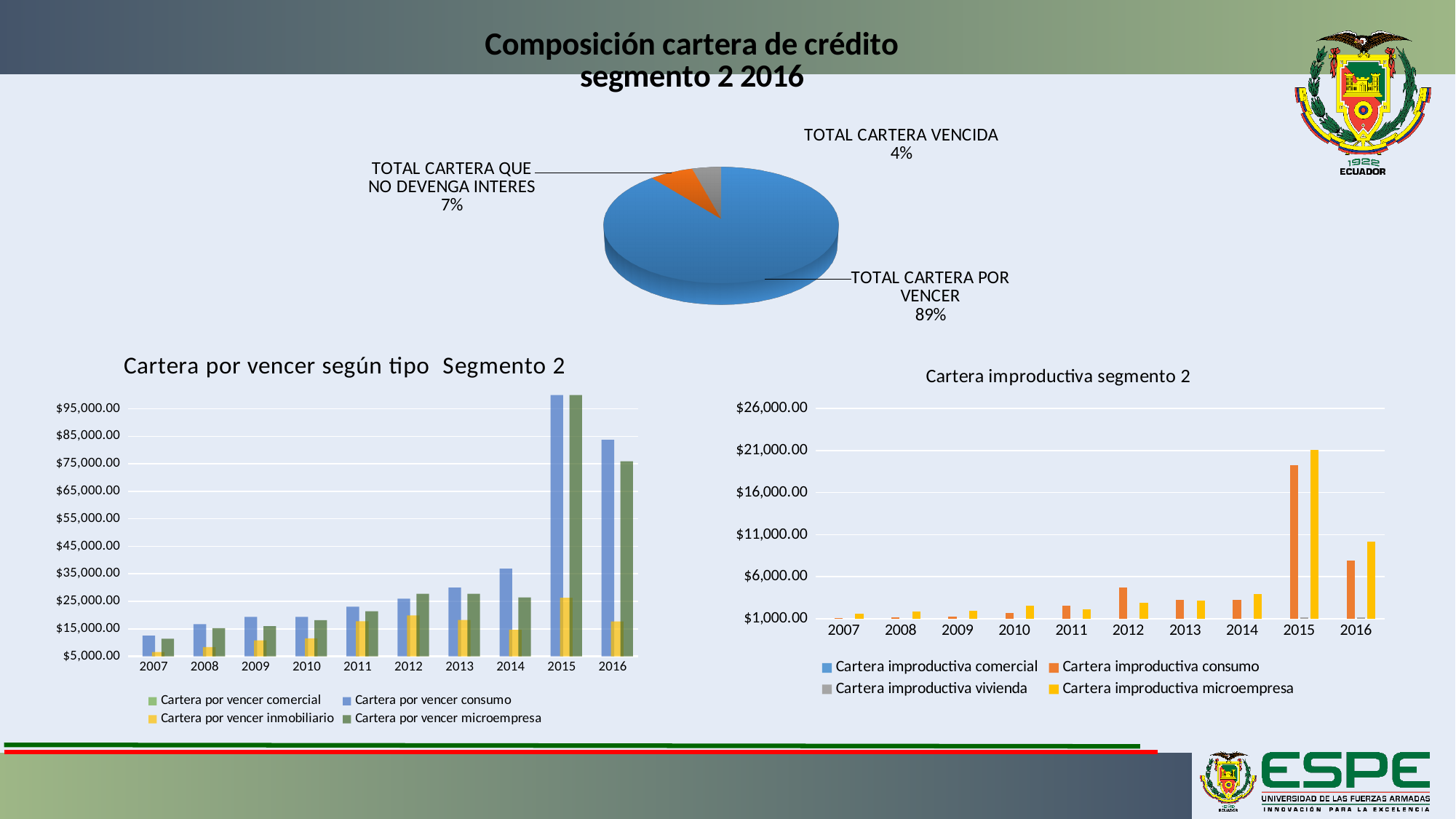
In the chart 'Cartera improductiva segmento 2', is the value for Cartera improductiva consumo in 2016 greater or less than $6,000.00? greater In the chart 'Cartera por vencer según tipo Segmento 2', how many series does the legend list? 4 In the chart 'Cartera por vencer según tipo Segmento 2', in which year is Cartera por vencer consumo highest? 2015 In the pie chart at the top of the slide, which slice is the smallest? TOTAL CARTERA VENCIDA In the chart 'Cartera por vencer según tipo Segmento 2', is the value for Cartera por vencer consumo in 2016 greater or less than $85,000.00? less What kind of chart is 'Cartera improductiva segmento 2'? bar chart In the pie chart at the top of the slide, what share is TOTAL CARTERA QUE NO DEVENGA INTERES? 7% In the pie chart at the top of the slide, what share is TOTAL CARTERA VENCIDA? 4% In the chart 'Cartera por vencer según tipo Segmento 2', how many years are shown on the x axis? 10 In the pie chart at the top of the slide, what share is TOTAL CARTERA POR VENCER? 89% In the pie chart at the top of the slide, how many slices are there? 3 In the chart 'Cartera improductiva segmento 2', which series has the tallest bar in 2015? Cartera improductiva microempresa